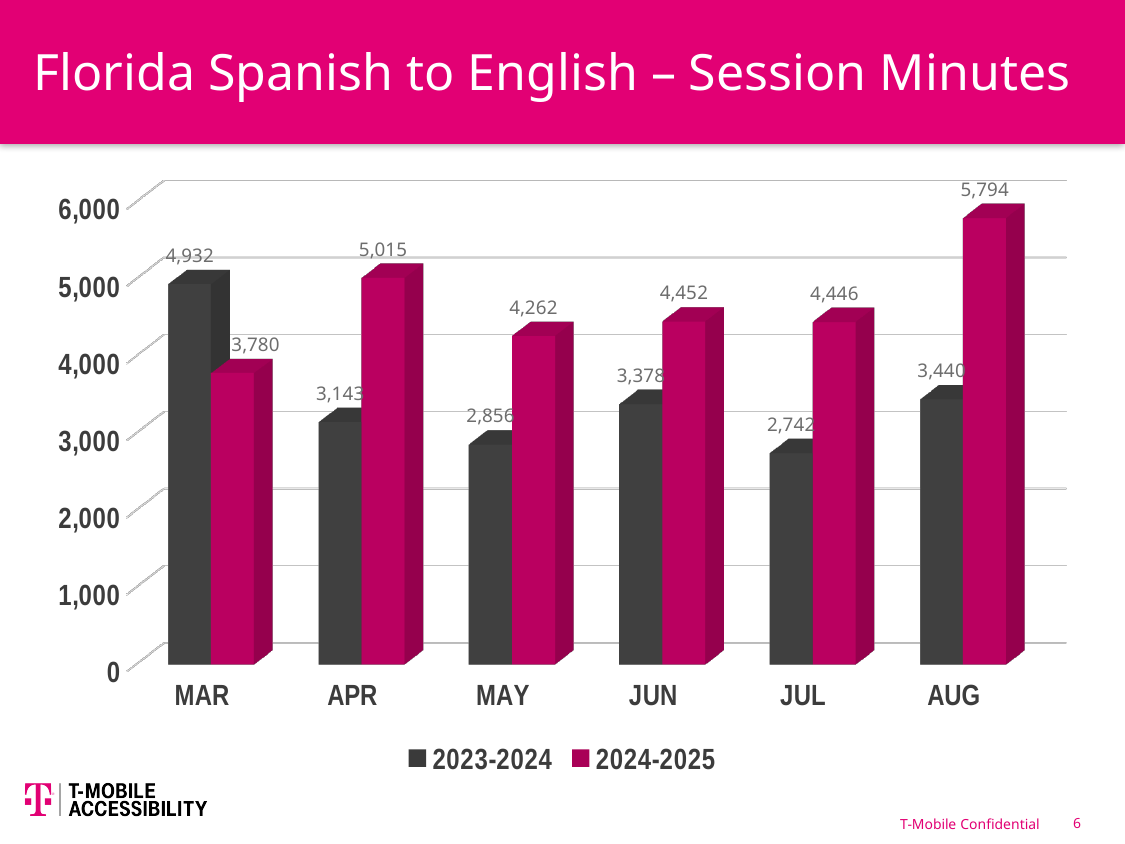
Which month has the lowest 2023-2024 value? JUL What is the difference between the 2024-2025 and 2023-2024 values for APR? 1,872 What is the 2024-2025 value for AUG? 5,794 What is the title of the chart? Florida Spanish to English – Session Minutes How many series does the legend list? 2 Which is larger for MAR, the 2023-2024 value or the 2024-2025 value? 2023-2024 Is the 2023-2024 value for JUN greater or less than 3,000? greater What is the 2024-2025 value for MAY? 4,262 What kind of chart is shown on the slide? bar chart Which month has the highest 2024-2025 value? AUG What is the 2023-2024 value for MAR? 4,932 How many months are shown on the x axis? 6